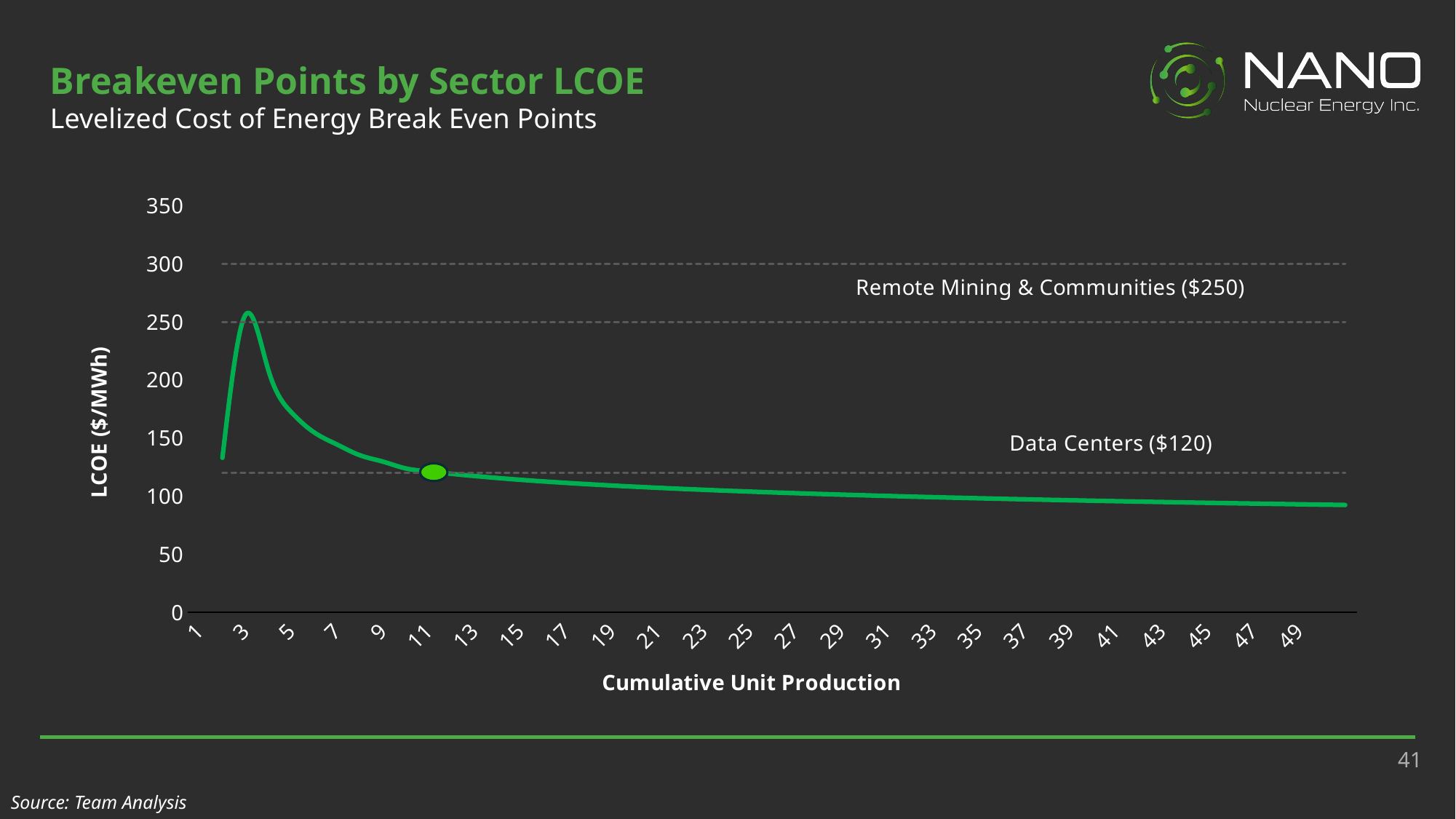
Is the LCOE value at cumulative unit production 3 greater or less than 200? greater After its peak near cumulative unit production 3, does the LCOE curve rise or fall as cumulative unit production increases? fall What is the label of the y axis? LCOE ($/MWh) What LCOE value is given for the Data Centers breakeven line? $120 Is the LCOE value at cumulative unit production 1 greater or less than 200? less Which breakeven line is higher, Remote Mining & Communities or Data Centers? Remote Mining & Communities What kind of chart is shown on the slide? line chart How many tick labels are shown on the x axis? 25 Is the LCOE value at cumulative unit production 49 greater or less than 150? less What is the title of the chart on the slide? Breakeven Points by Sector LCOE What LCOE value is given for the Remote Mining & Communities breakeven line? $250 What is the difference between the Remote Mining & Communities breakeven value and the Data Centers breakeven value? $130